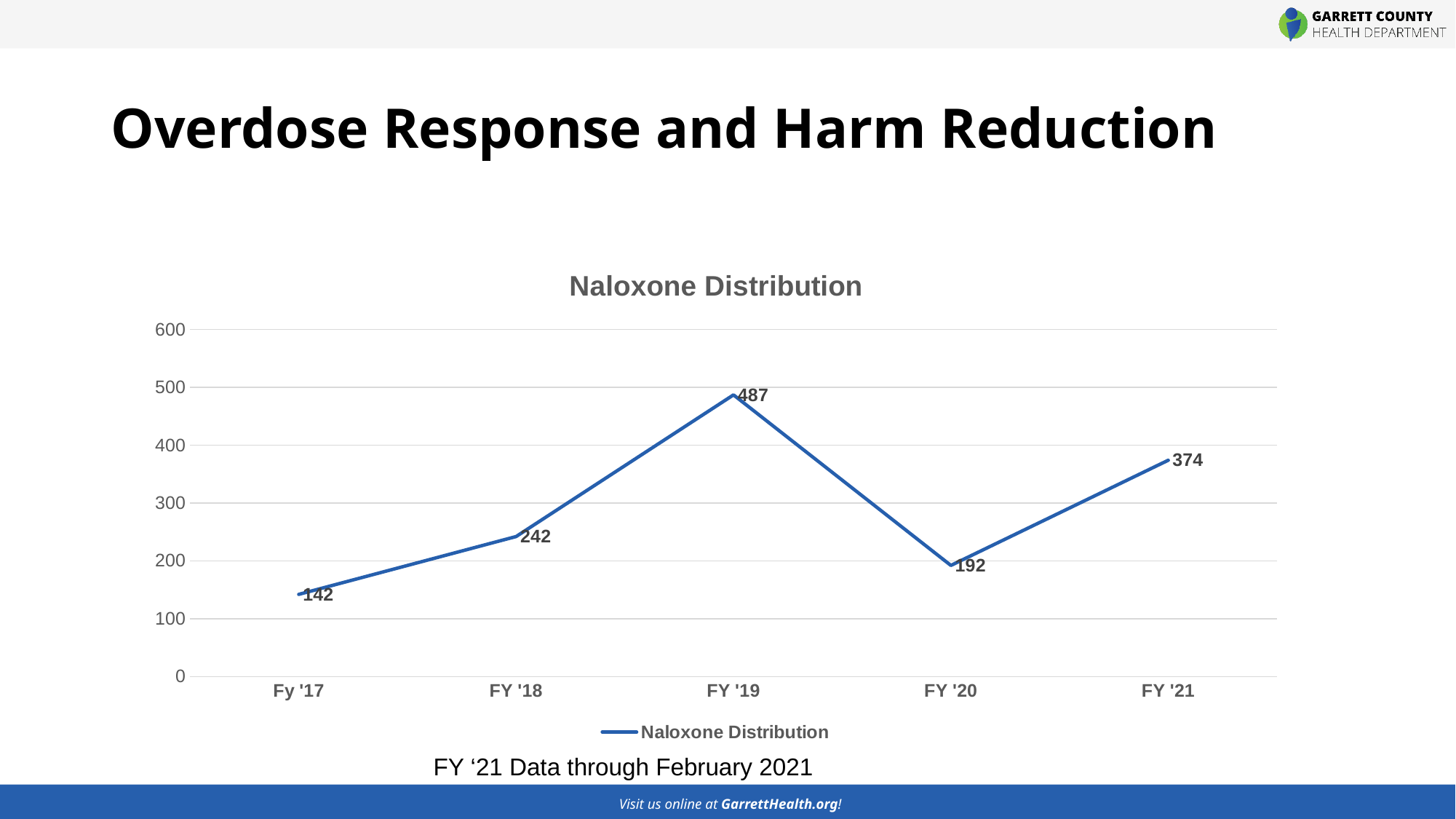
What kind of chart is the Naloxone Distribution chart? Line chart What is the Naloxone Distribution value for FY '21? 374 What is the Naloxone Distribution value for FY '19? 487 What is the Naloxone Distribution value for Fy '17? 142 How many series does the legend of the Naloxone Distribution chart list? 1 How many fiscal years are plotted on the Naloxone Distribution chart? 5 Does the Naloxone Distribution value rise or fall from FY '20 to FY '21? Rise Which fiscal year has the highest Naloxone Distribution value? FY '19 Which is larger, the Naloxone Distribution value for FY '18 or for FY '20? FY '18 What is the difference between the Naloxone Distribution values for FY '19 and FY '20? 295 What is the difference between the Naloxone Distribution values for FY '18 and Fy '17? 100 Which fiscal year has the lowest Naloxone Distribution value? Fy '17